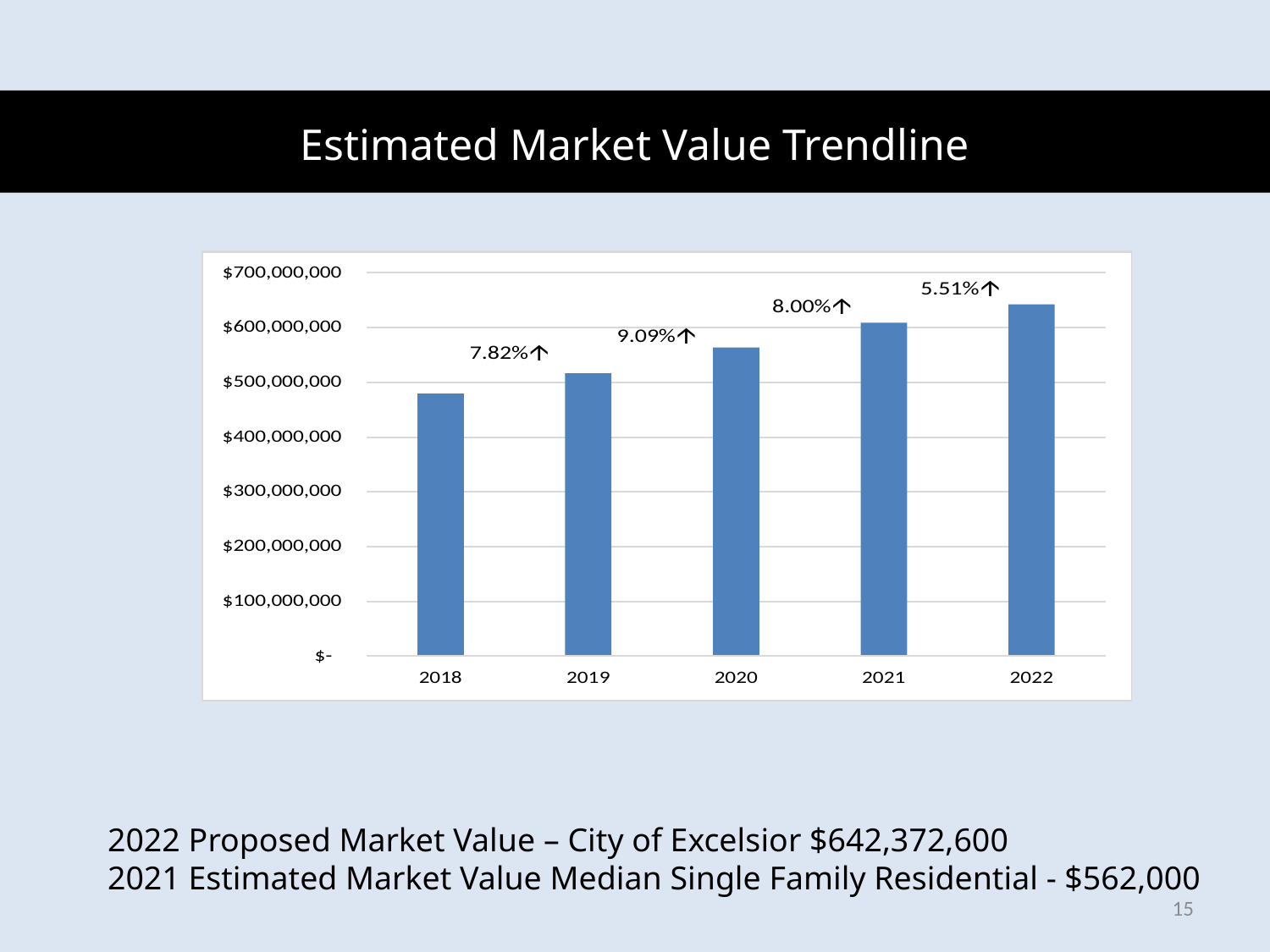
Which year has the highest estimated market value? 2022 Which year has the lowest estimated market value? 2018 What is the title of the chart? Estimated Market Value Trendline What percentage increase is labelled above the 2020 bar? 9.09% Do the bar values rise or fall from 2018 to 2022? rise What kind of chart is shown on the slide? bar chart Is the value for 2020 greater or less than $500,000,000? greater What percentage increase is labelled above the 2022 bar? 5.51% How many years are plotted on the x axis of the chart? 5 Is the value for 2022 greater or less than $600,000,000? greater Is the value for 2018 greater or less than $500,000,000? less Which year is labelled with the largest percentage increase? 2020